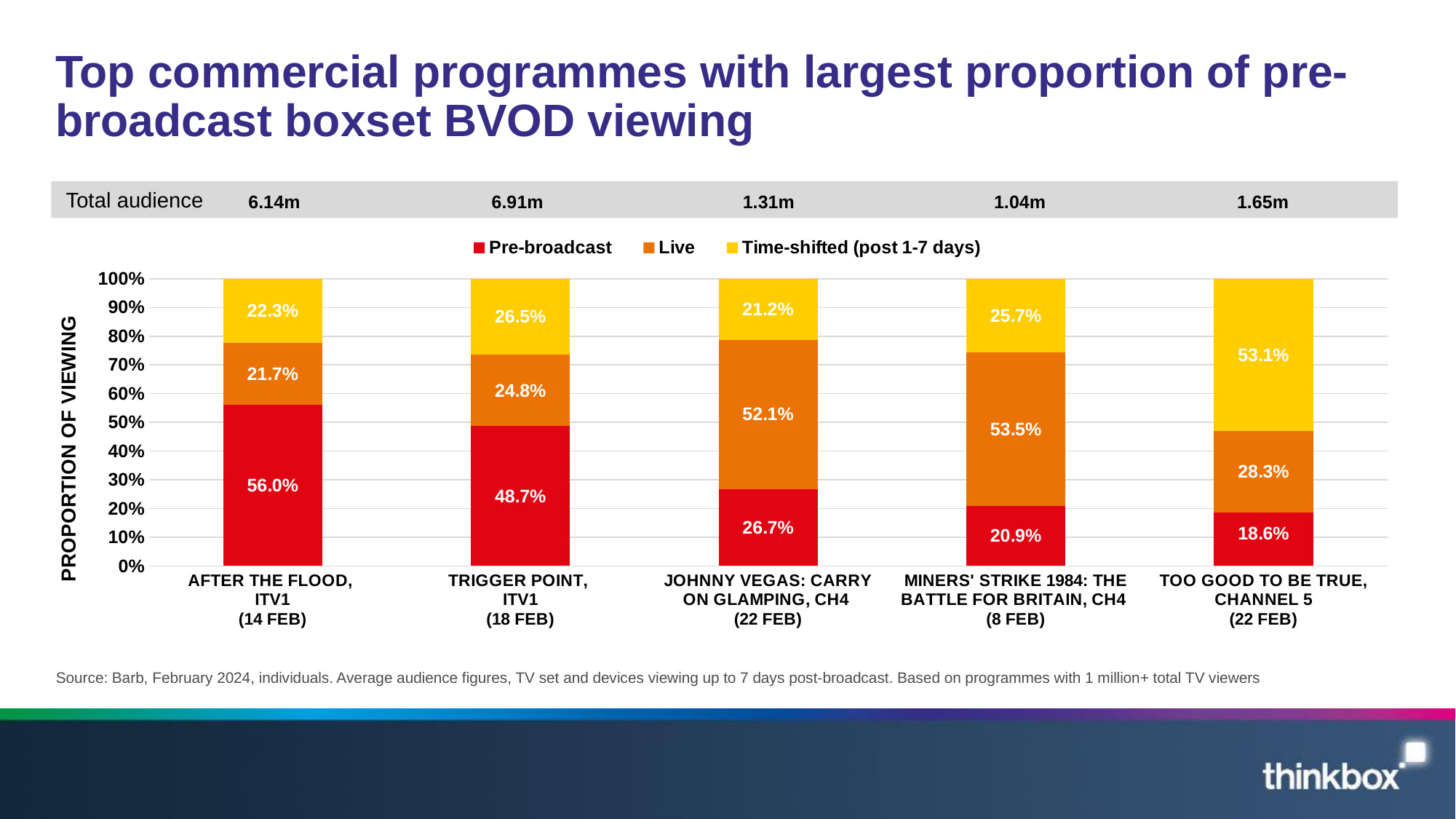
How many programmes are shown on the x axis? 5 What is the Live proportion of viewing for Miners' Strike 1984: The Battle for Britain, CH4 (8 Feb)? 53.5% Which programme has the lowest Pre-broadcast proportion of viewing? Too Good to Be True, Channel 5 (22 Feb) Which series is shown in red in the legend? Pre-broadcast What kind of chart is shown on the slide? Stacked bar chart How many series does the legend list? 3 What is the Time-shifted (post 1-7 days) proportion of viewing for Too Good to Be True, Channel 5 (22 Feb)? 53.1% Which is larger: the Live proportion for Johnny Vegas: Carry on Glamping, CH4 or the Live proportion for Too Good to Be True, Channel 5? Johnny Vegas: Carry on Glamping, CH4 Which programme has the highest Pre-broadcast proportion of viewing? After the Flood, ITV1 (14 Feb) What is the difference in Pre-broadcast proportion between After the Flood, ITV1 and Trigger Point, ITV1? 7.3 percentage points What is the Live proportion of viewing for Trigger Point, ITV1 (18 Feb)? 24.8% What is the Pre-broadcast proportion of viewing for After the Flood, ITV1 (14 Feb)? 56.0%